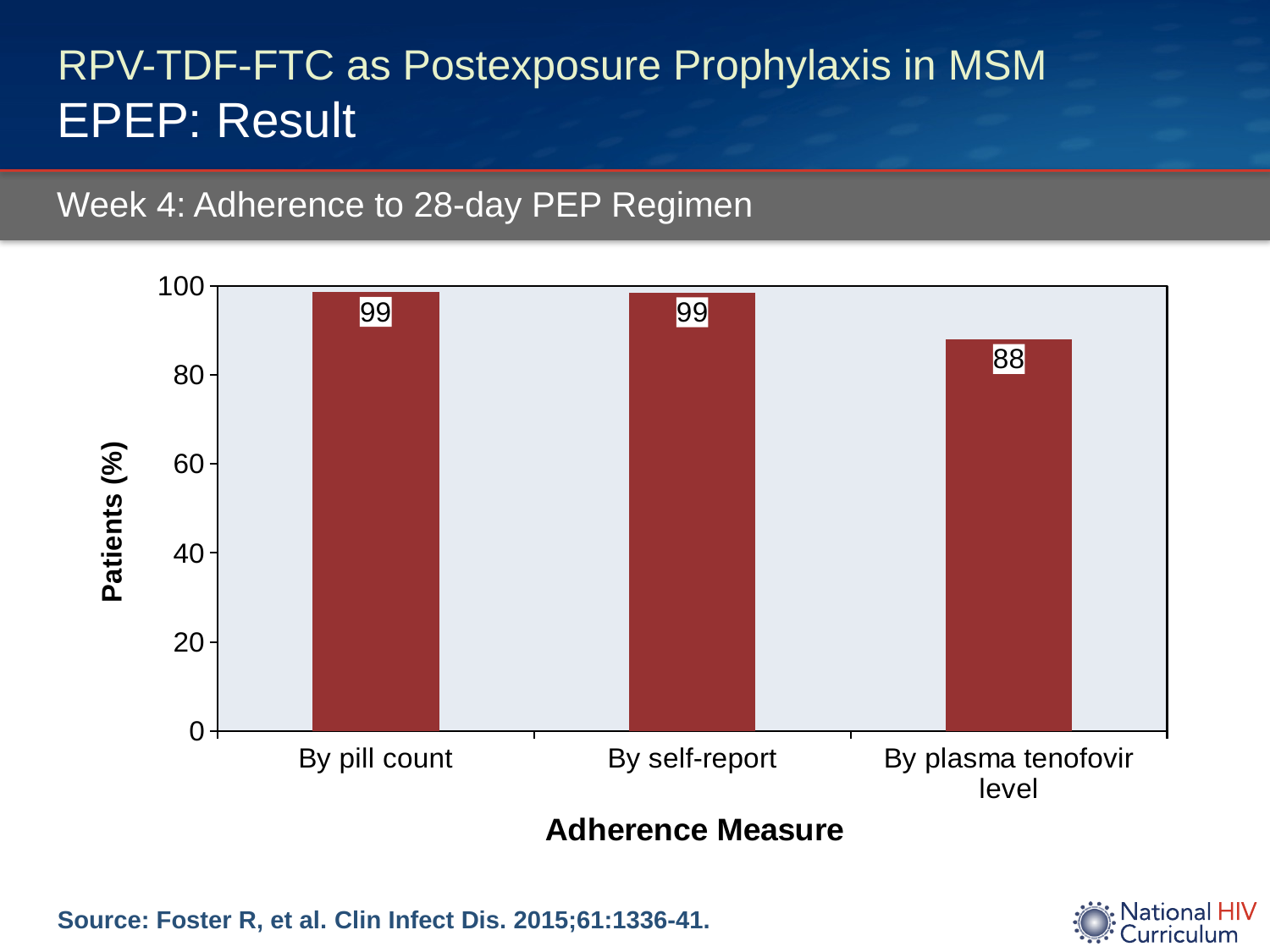
What kind of chart is shown on the slide? Bar chart What is the value for By self-report? 99 Which adherence measure has the lowest value? By plasma tenofovir level What is the difference between the value for By pill count and the value for By plasma tenofovir level? 11 What is the value for By pill count? 99 What is the label of the y axis? Patients (%) What is the label of the x axis? Adherence Measure Is the value for By plasma tenofovir level greater or less than 80? greater How many adherence measures are shown on the chart? 3 What is the value for By plasma tenofovir level? 88 Which is larger, the value for By self-report or the value for By plasma tenofovir level? By self-report Is the value for By pill count greater or less than 80? greater